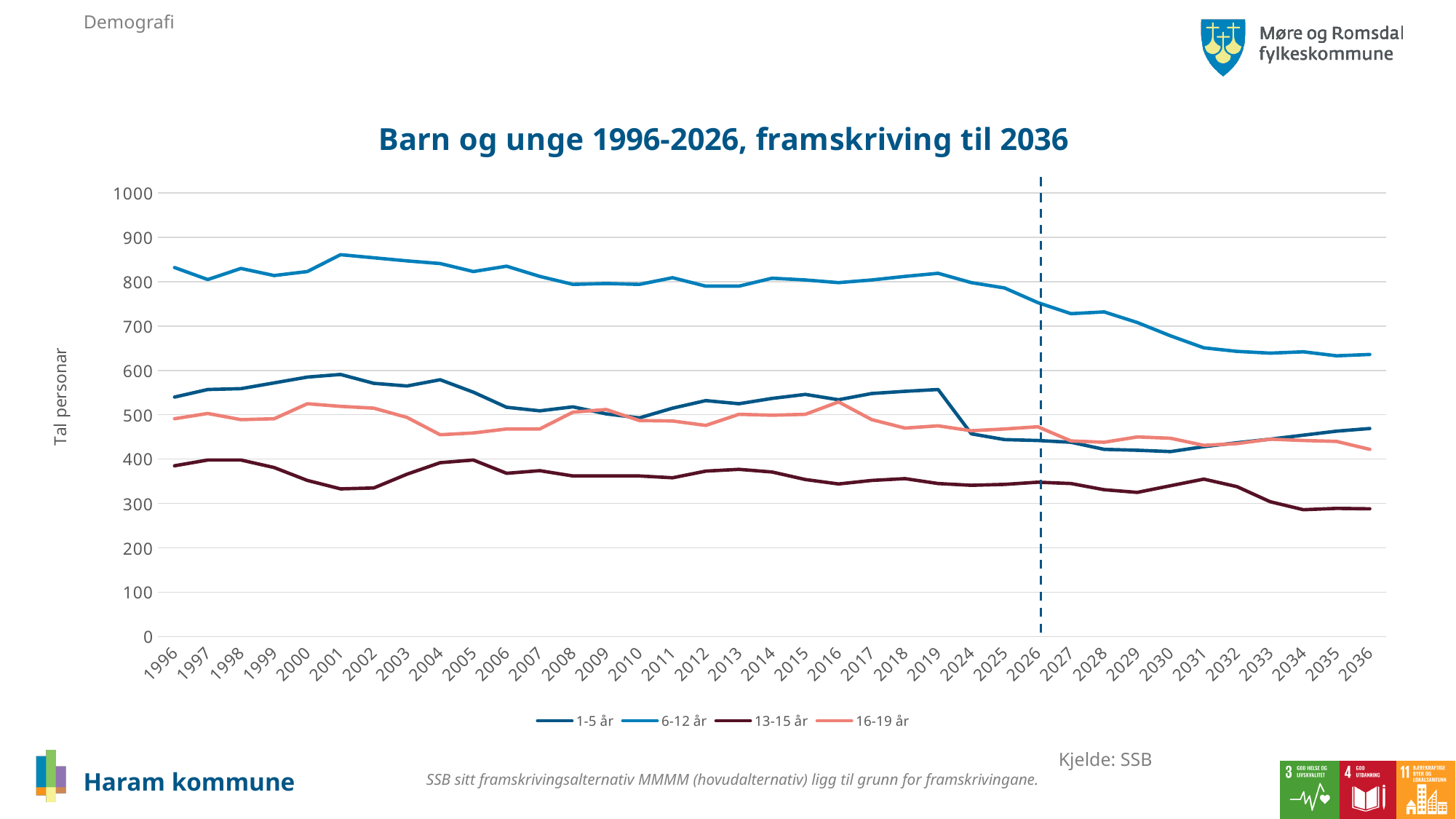
Is the value for 13-15 år in 2036 greater or less than 300? less In 2036, which is larger: the value for 16-19 år or the value for 13-15 år? 16-19 år Does the 6-12 år series rise or fall from 2019 to 2036? fall Which series has the lowest values across the whole chart? 13-15 år Is the value for 6-12 år in 2001 greater or less than 800? greater How many years are shown along the x axis? 37 Is the value for 16-19 år in 2004 greater or less than 500? less What kind of chart is shown on the slide? line chart What is the title of the chart? Barn og unge 1996-2026, framskriving til 2036 How many series does the legend list? 4 Which series has the highest values across the whole chart? 6-12 år